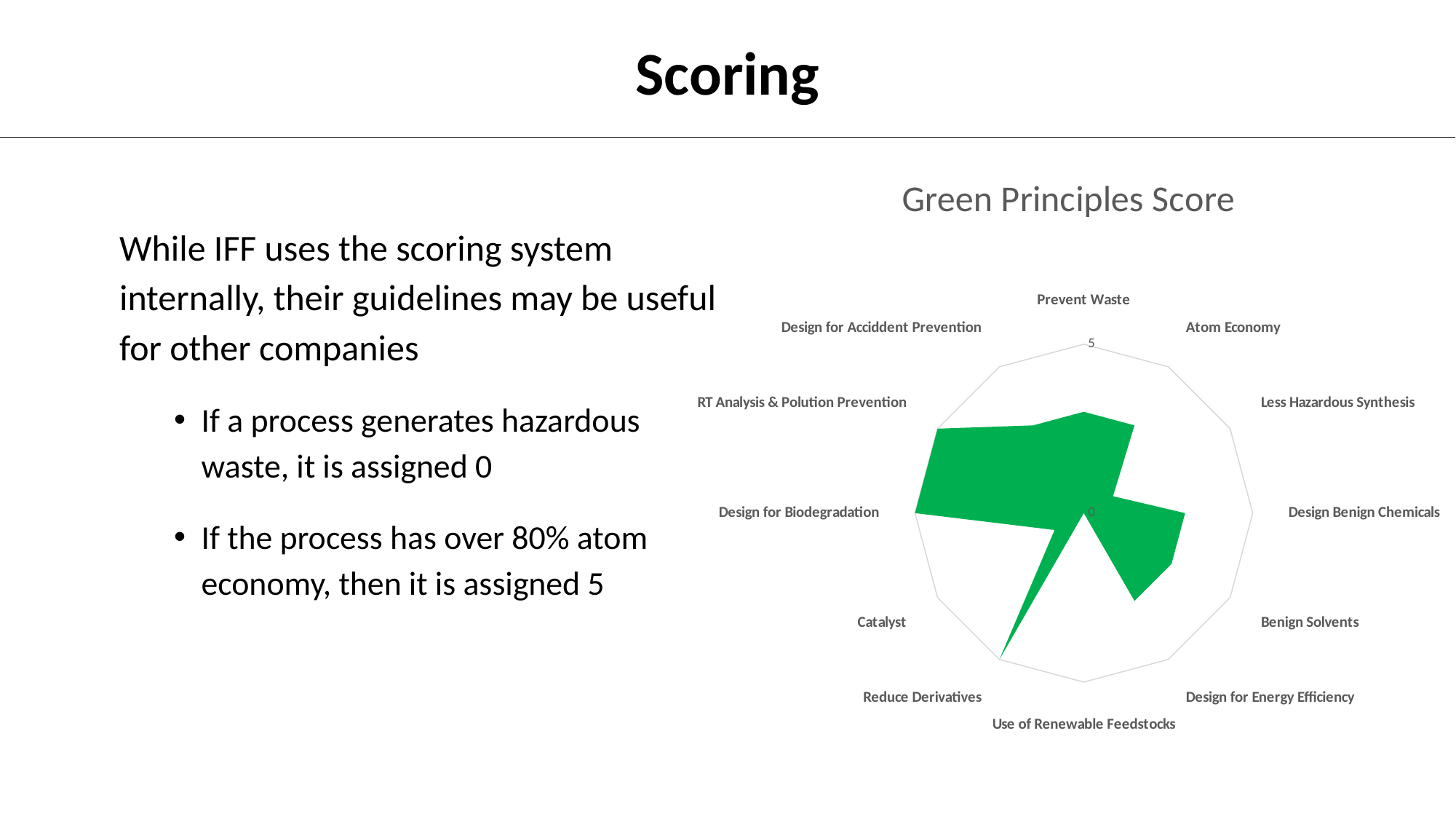
Is the value for Atom Economy greater or less than 0? greater What colour is the filled area of the radar chart? Green Which has the larger value, Reduce Derivatives or Use of Renewable Feedstocks? Reduce Derivatives Is the value for Catalyst greater or less than 5? less How many categories (principles) are plotted on the radar chart? 12 Is the value for Design Benign Chemicals greater or less than 5? less Which has the larger value, Design for Biodegradation or Prevent Waste? Design for Biodegradation What kind of chart is shown on the slide? Radar chart Which has the larger value, Prevent Waste or Catalyst? Prevent Waste What is the title of the chart? Green Principles Score